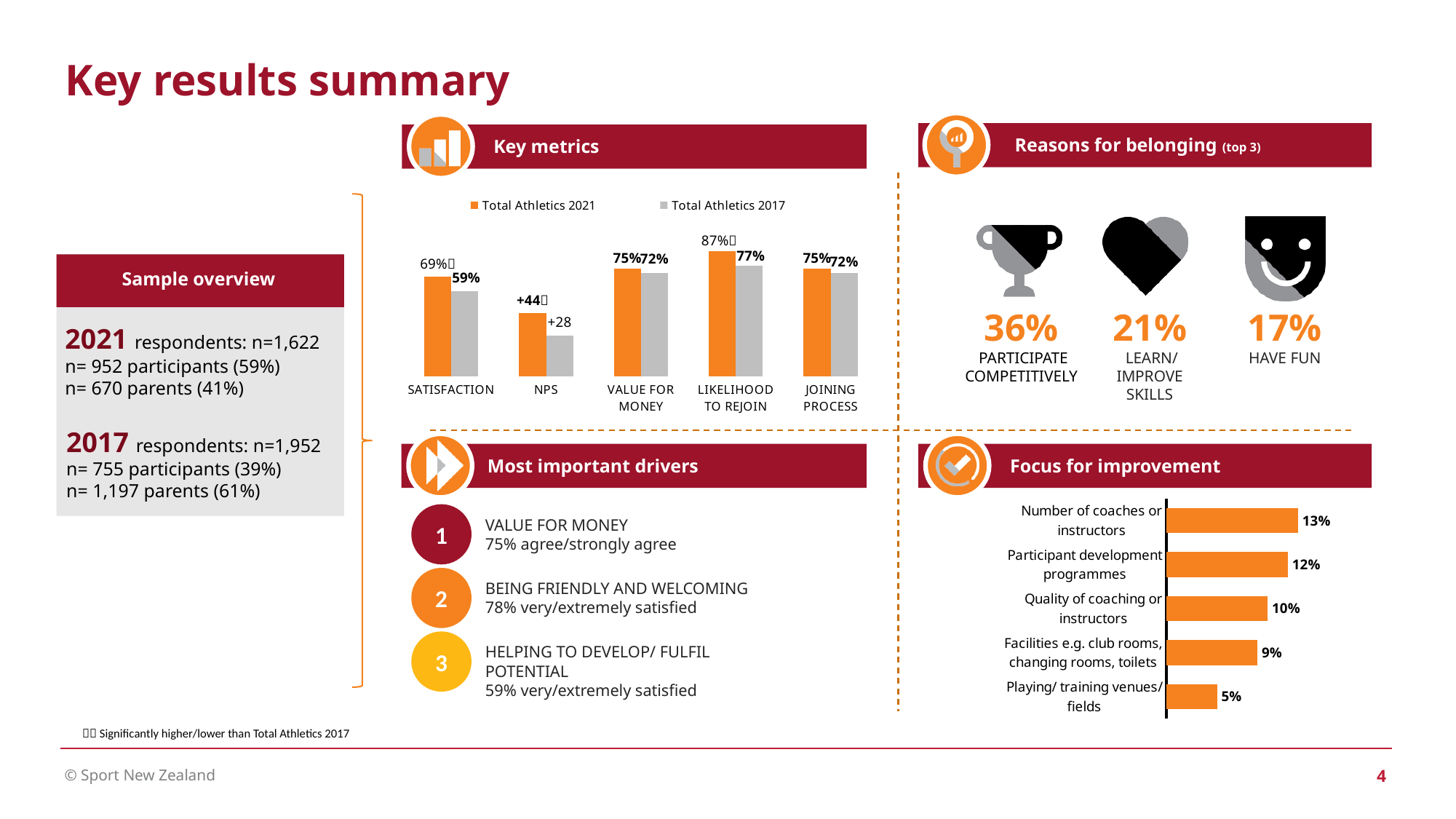
In the Key metrics chart, how many categories are shown on the x axis? 5 In the Key metrics chart, what is the difference between the 2021 and 2017 values for Satisfaction? 10 percentage points In the Key metrics chart, what is the Total Athletics 2017 value for Likelihood to rejoin? 77% In the Key metrics chart, how many series does the legend list? 2 In the Focus for improvement chart, what is the value for Quality of coaching or instructors? 10% What type of chart is the Focus for improvement chart? Bar chart In the Key metrics chart, which colour represents Total Athletics 2021? Orange In the Focus for improvement chart, which item has the lowest value? Playing/ training venues/ fields In the Focus for improvement chart, what is the difference between Number of coaches or instructors and Facilities e.g. club rooms, changing rooms, toilets? 4 percentage points In the Key metrics chart, which category has the highest Total Athletics 2021 value? Likelihood to rejoin In the Key metrics chart, what is the Total Athletics 2021 value for Satisfaction? 69% In the Key metrics chart, what is the NPS value for Total Athletics 2017? +28